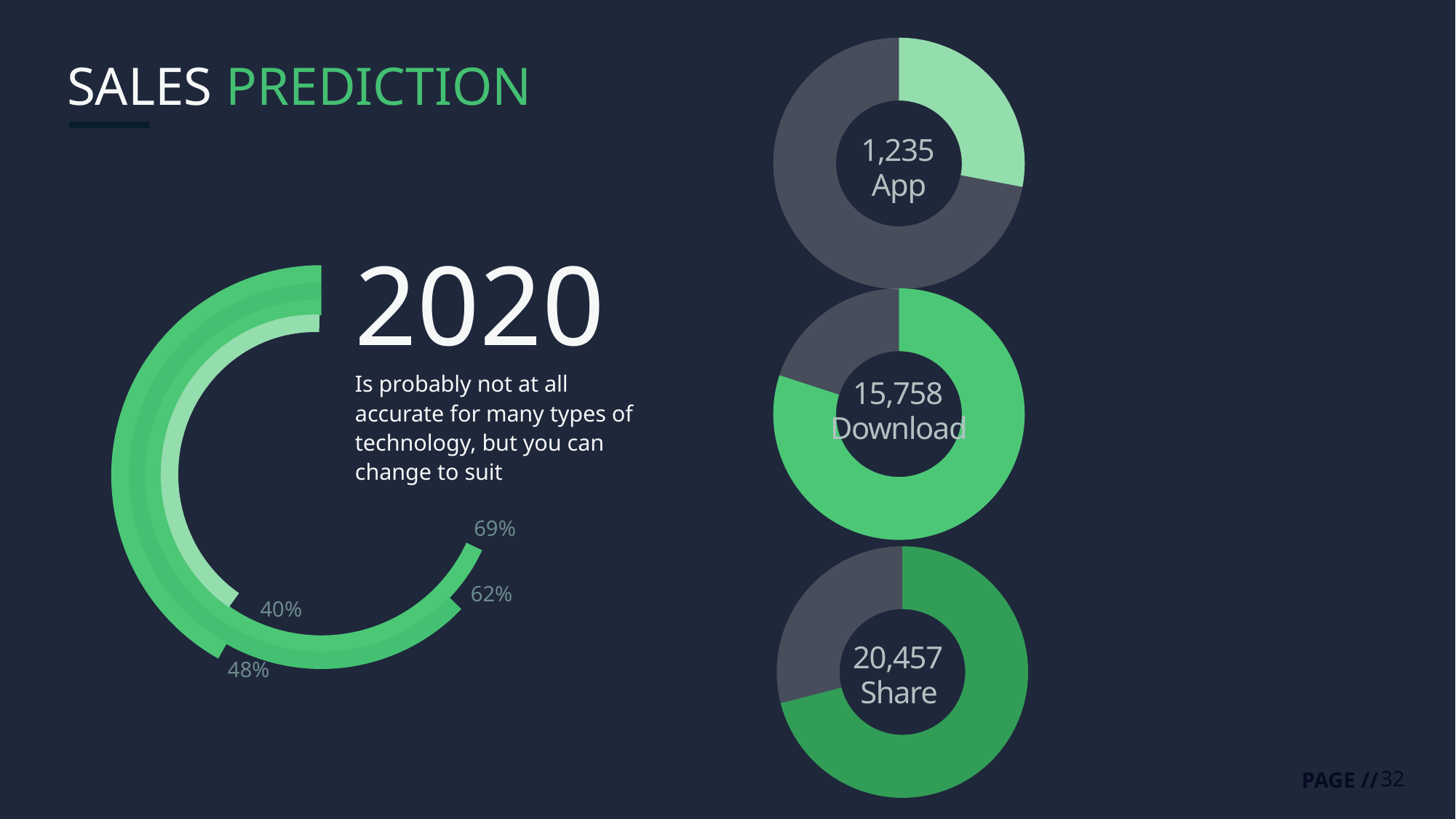
What kind of chart is used for App, Download and Share on the right of the slide? Donut chart Among the three donut charts on the right, which one shows the lowest centre value? App How many donut charts are on the right side of the slide? 3 What is the difference between the Share value and the Download value shown in the donut charts? 4,699 What value is shown in the centre of the Download donut chart? 15,758 In the arc chart on the left, what is the highest percentage label shown? 69% What value is shown in the centre of the Share donut chart? 20,457 Which donut chart on the right has the largest green portion of its ring? Download Which is larger, the Download value or the App value in the donut charts? Download What value is shown in the centre of the App donut chart? 1,235 Among the three donut charts on the right, which one shows the highest centre value? Share What is the difference between the Download value and the App value shown in the donut charts? 14,523